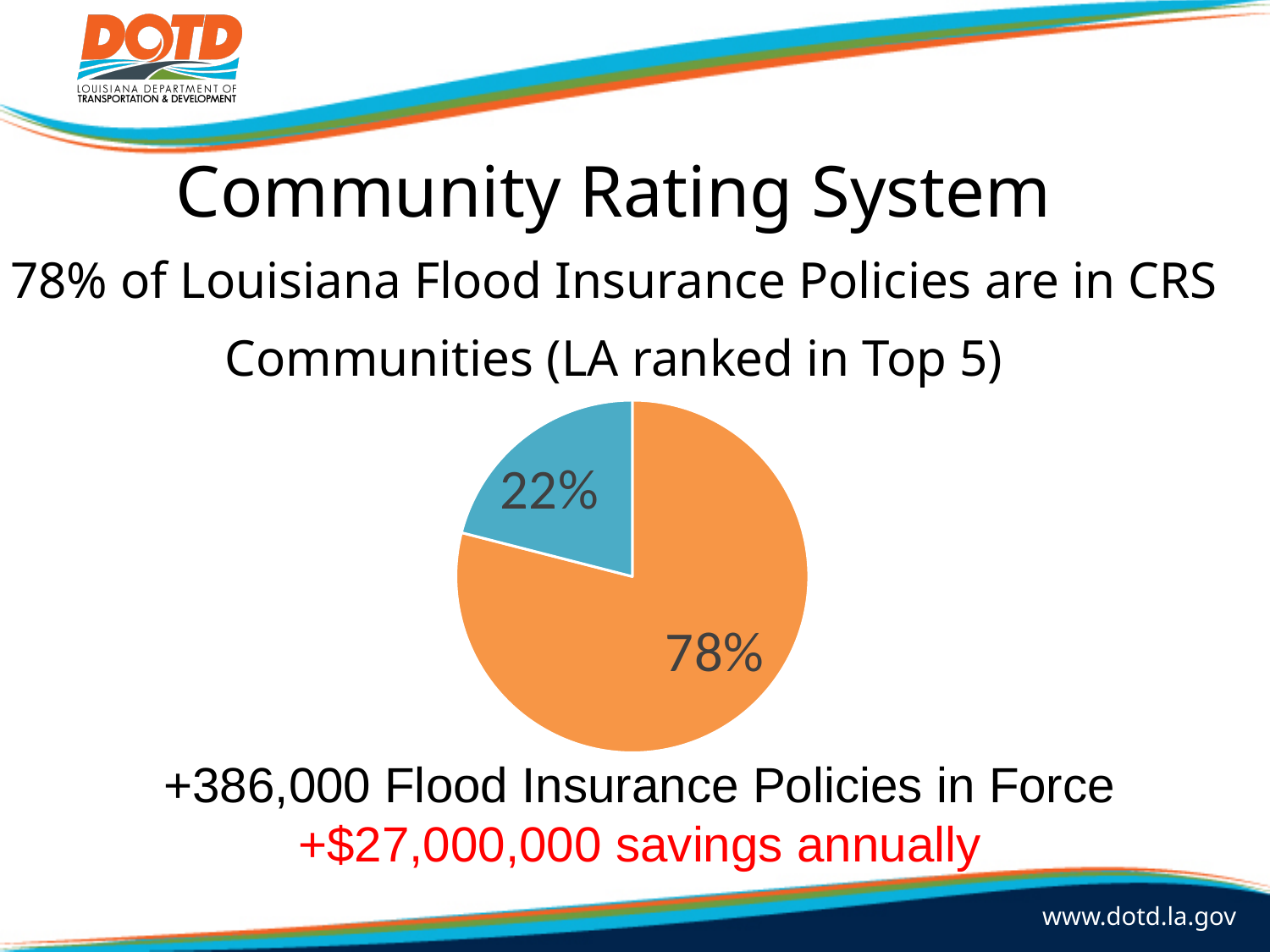
According to the slide, what percentage of Louisiana Flood Insurance Policies are in CRS Communities? 78% What share of the pie does the blue slice represent? 22% What kind of chart is shown on the slide? pie chart How many slices does the pie chart have? 2 What is the largest value shown on the pie chart? 78% What is the difference in percentage points between the two slices of the pie chart? 56 What colour is the slice labelled 22%? blue What is the smallest value shown on the pie chart? 22% What share of the pie does the orange slice represent? 78% Which slice is larger, the orange slice or the blue slice? the orange slice What colour is the slice labelled 78%? orange Is the value of the blue slice greater or less than 25%? less